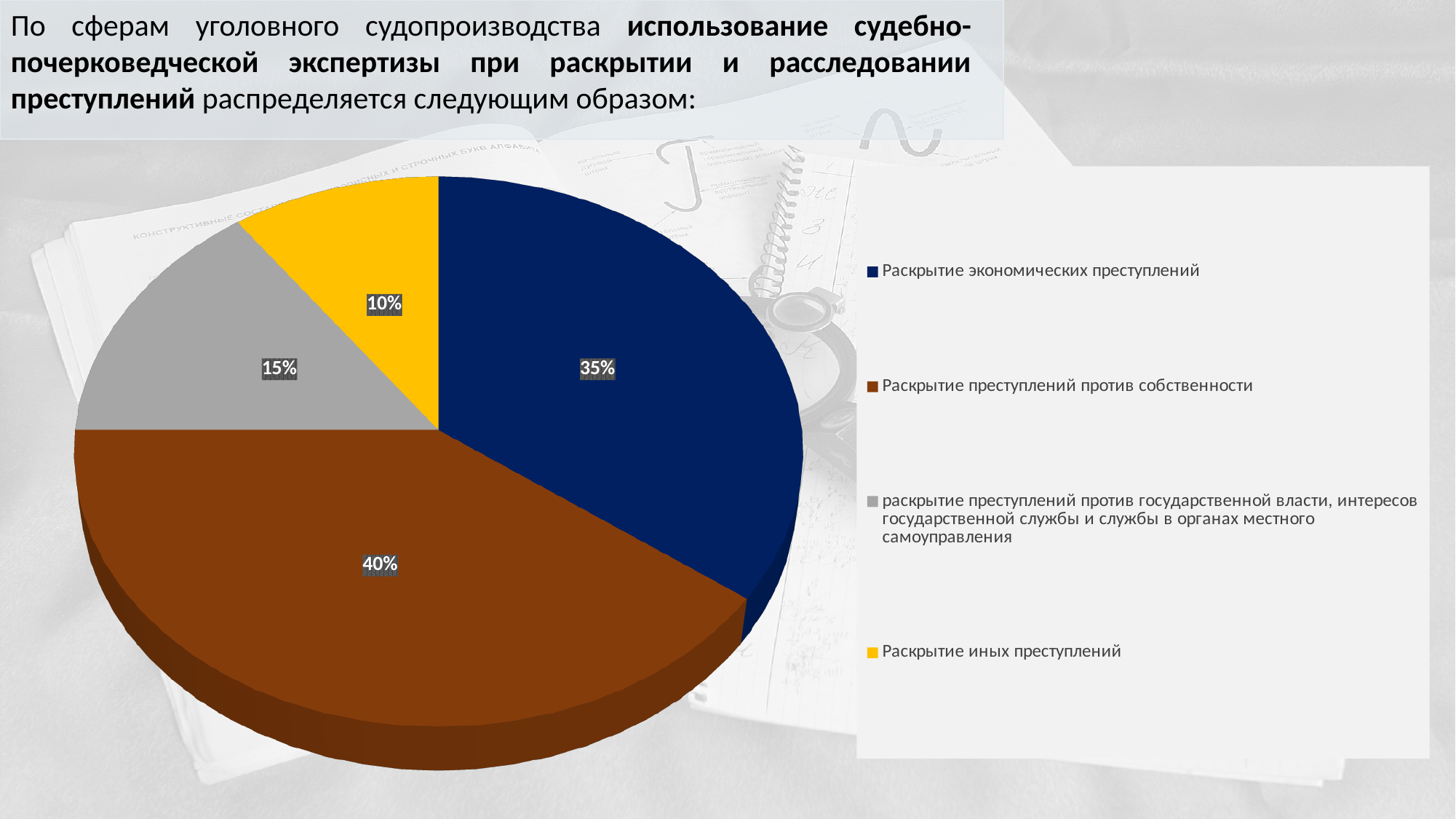
What kind of chart is shown on the slide? pie chart Which is larger: the slice for 'Раскрытие экономических преступлений' or the slice for 'Раскрытие иных преступлений'? Раскрытие экономических преступлений What is the difference in percentage points between 'Раскрытие преступлений против собственности' and 'Раскрытие экономических преступлений'? 5% How many slices does the pie chart have? 4 What share of the pie is labelled for 'Раскрытие экономических преступлений'? 35% What share of the pie is labelled for 'Раскрытие преступлений против собственности'? 40% What colour is the slice for 'Раскрытие экономических преступлений'? dark blue What share of the pie is labelled for 'Раскрытие иных преступлений'? 10% What share of the pie is labelled for 'раскрытие преступлений против государственной власти, интересов государственной службы и службы в органах местного самоуправления'? 15% What colour is the slice for 'Раскрытие иных преступлений'? yellow Which category has the smallest slice of the pie? Раскрытие иных преступлений Which category has the largest slice of the pie? Раскрытие преступлений против собственности